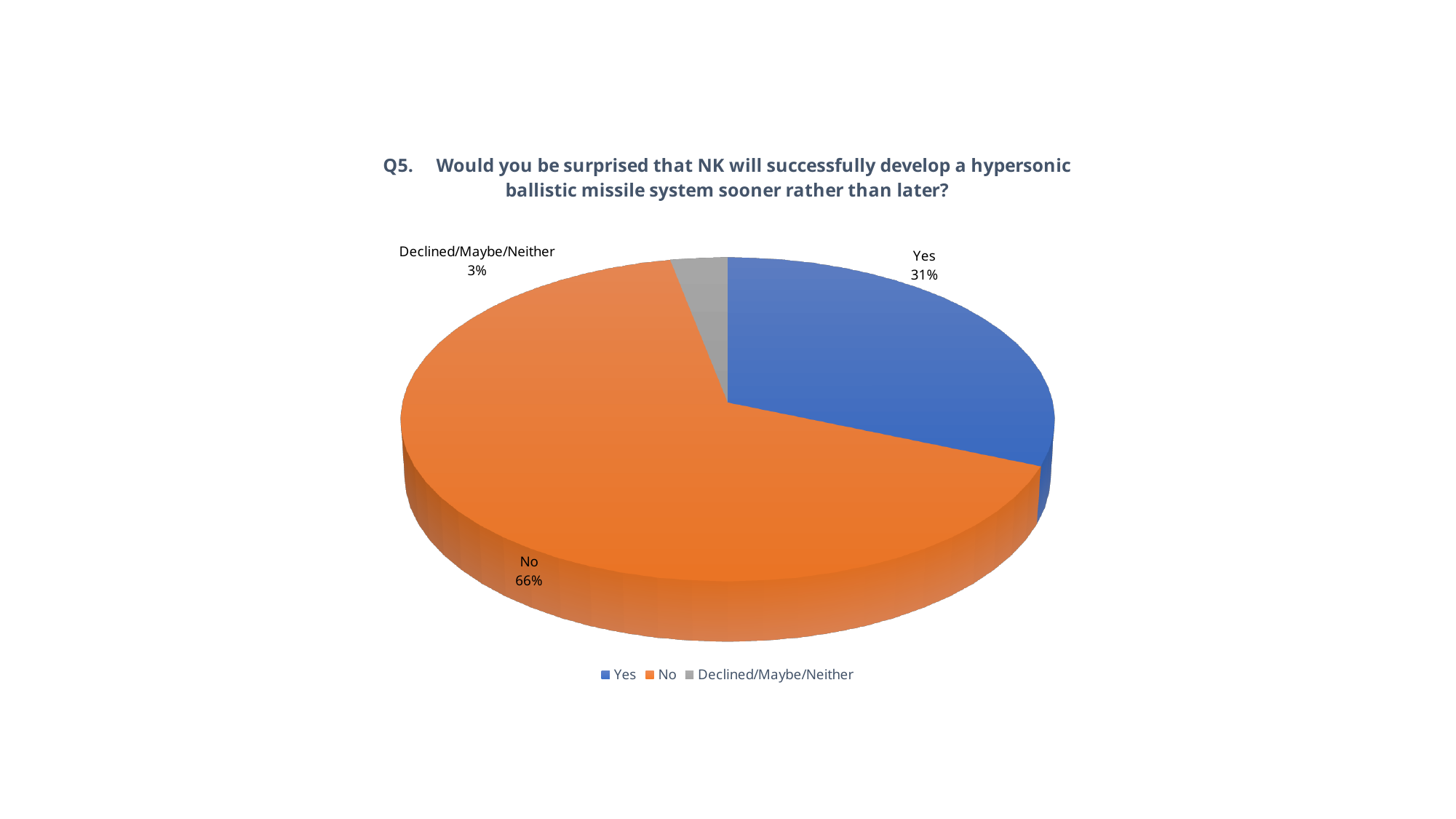
How many slices does the pie chart have? 3 What is the difference in percentage points between the "No" and "Yes" shares? 35 What share of the pie is labelled "Declined/Maybe/Neither"? 3% Which is larger, the "Yes" share or the "Declined/Maybe/Neither" share? Yes Which response has the largest share of the pie? No Which response has the smallest share of the pie? Declined/Maybe/Neither What colour is the "No" slice? Orange What kind of chart is shown on the slide? Pie chart What question number is shown in the chart title? Q5 What percentage of respondents answered "No"? 66% How many entries does the legend list? 3 What percentage of respondents answered "Yes"? 31%